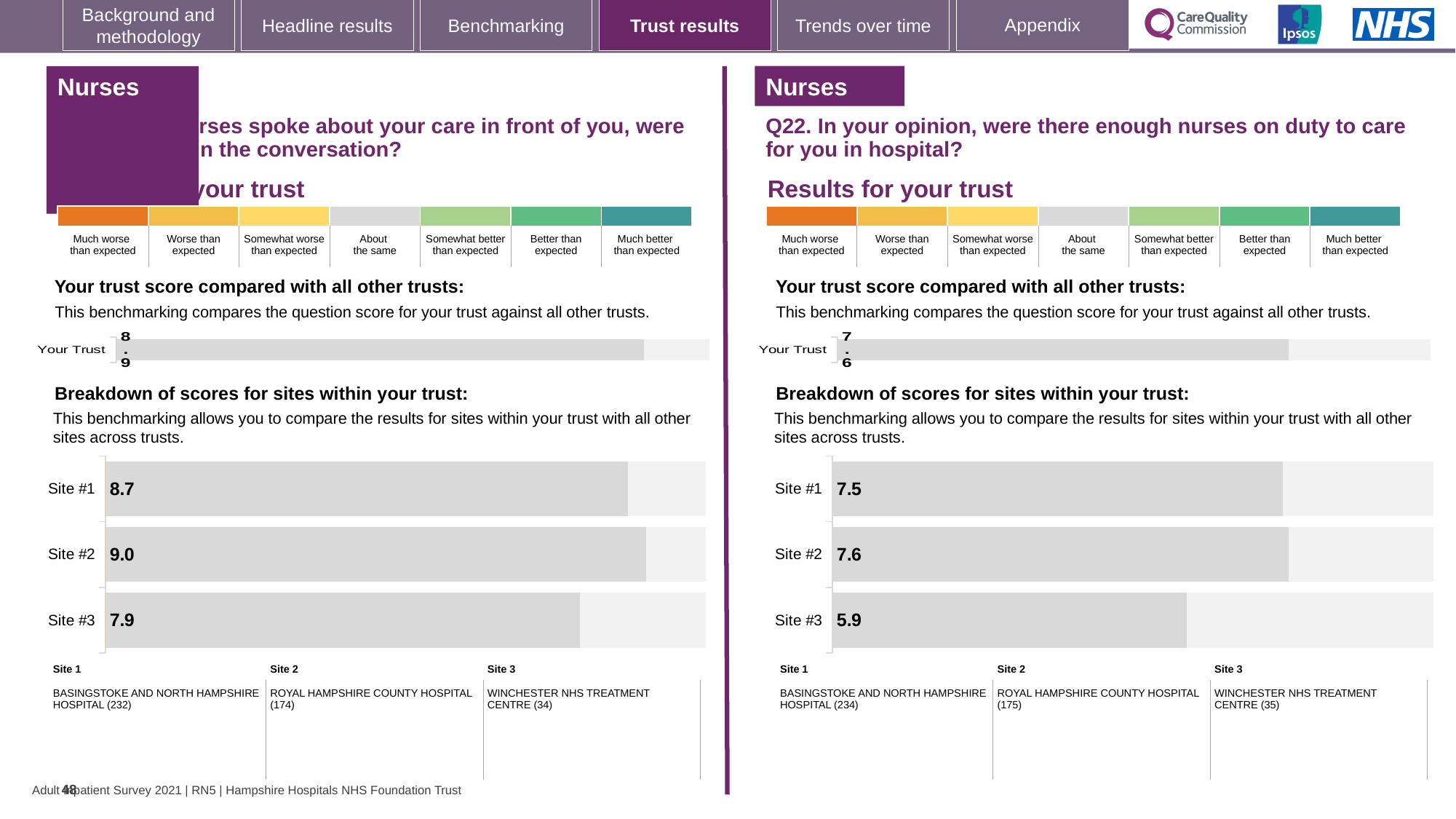
On the right-hand site breakdown chart for Q22, what is the difference between the scores for Site #2 and Site #3? 1.7 What type of chart is used for the site breakdown on the left-hand side of the slide? Bar chart On the left-hand site breakdown chart, what is the score for Site #3? 7.9 On the right-hand site breakdown chart for Q22, which site has the lowest score? Site #3 On the right-hand 'Your trust score compared with all other trusts' chart for Q22, what is the score for Your Trust? 7.6 Which is larger: the Site #1 score on the left-hand site breakdown chart or the Site #1 score on the right-hand site breakdown chart for Q22? Left-hand chart (8.7) On the left-hand 'Your trust score compared with all other trusts' chart, what is the score for Your Trust? 8.9 How many sites are shown on the right-hand site breakdown chart for Q22? 3 On the right-hand site breakdown chart for Q22, what is the score for Site #1? 7.5 On the left-hand site breakdown chart, which site has the highest score? Site #2 On the left-hand site breakdown chart, what is the score for Site #2? 9.0 On the left-hand site breakdown chart, what is the difference between the scores for Site #2 and Site #3? 1.1